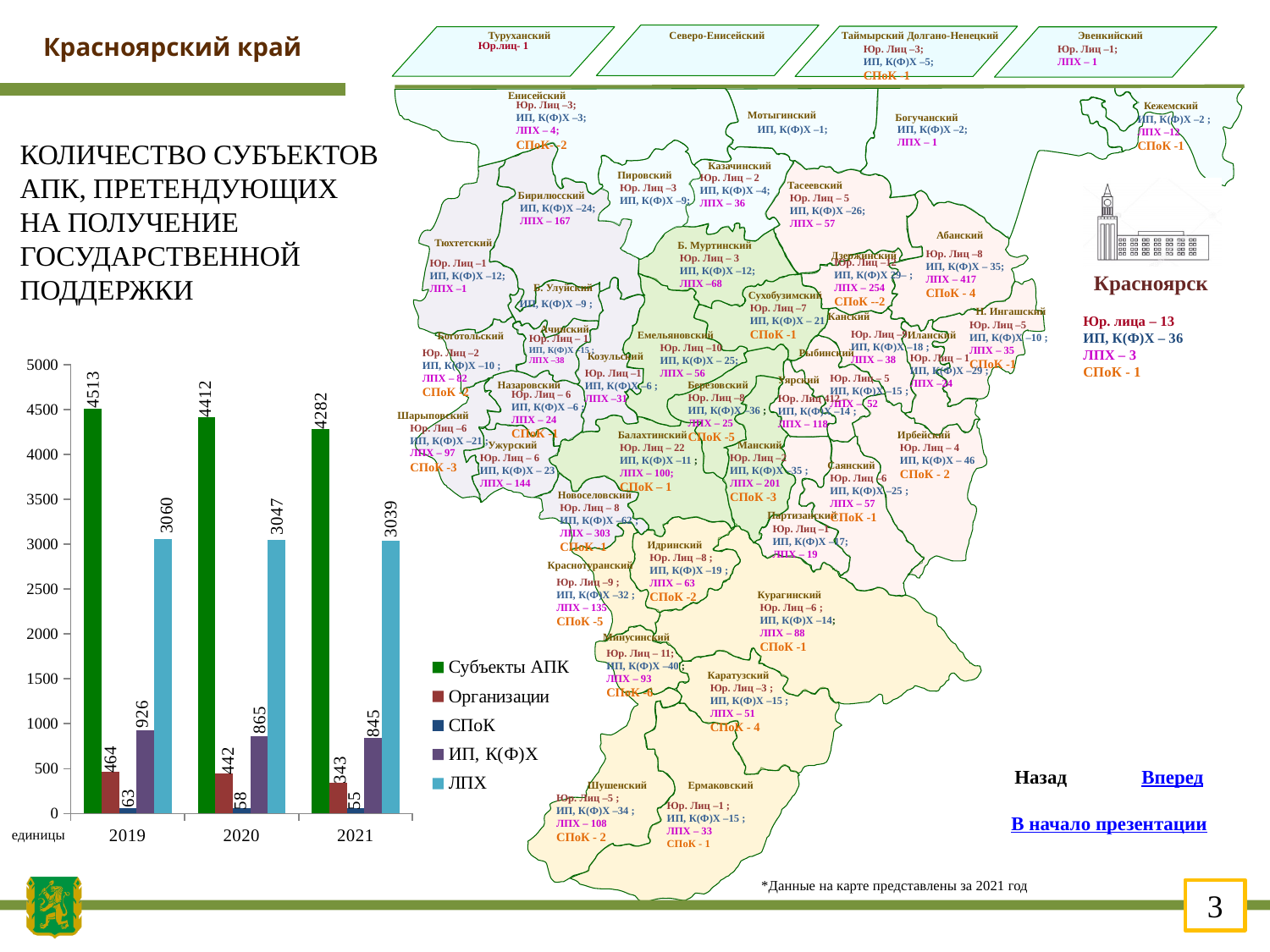
In which year is the value for Организации the lowest? 2021 Which is larger: ИП, К(Ф)Х in 2019 or ИП, К(Ф)Х in 2021? ИП, К(Ф)Х in 2019 What is the value for СПоК in 2019? 63 What is the value for Организации in 2021? 343 In which year is the value for Субъекты АПК the highest? 2019 What is the value for ЛПХ in 2021? 3039 How many series does the legend of the bar chart list? 5 What is the value for Субъекты АПК in 2019? 4513 Do the values for Субъекты АПК rise or fall from 2019 to 2021? fall What is the value for ИП, К(Ф)Х in 2020? 865 What kind of chart is shown on the slide? bar chart What is the difference between the Субъекты АПК values for 2019 and 2021? 231